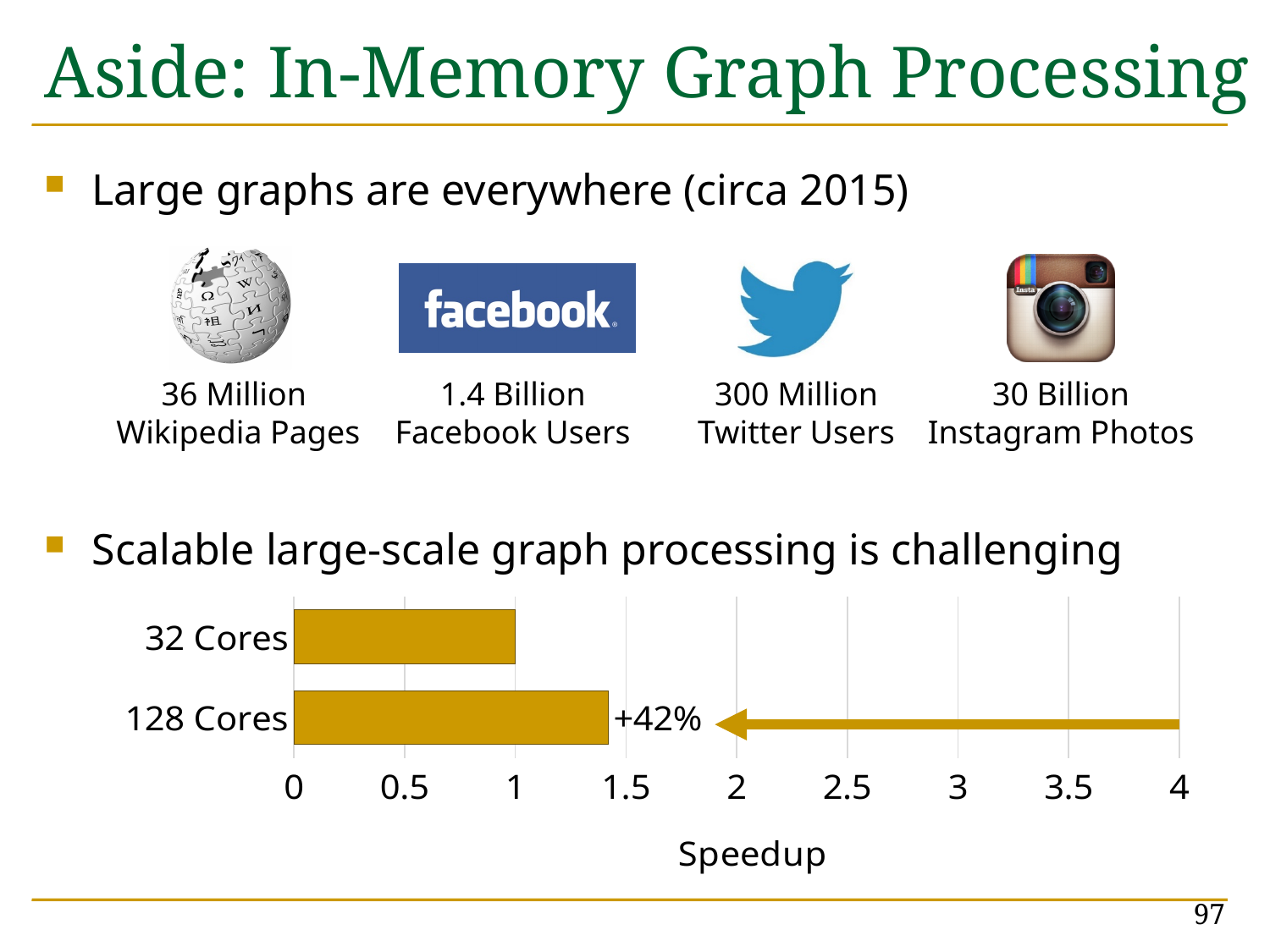
What is the label of the horizontal axis of the bar chart? Speedup Which category has the lowest speedup? 32 Cores Is the speedup for 128 Cores greater or less than 2? less What is the maximum value shown on the Speedup axis? 4 What is the speedup value for 32 Cores? 1 How many categories are plotted in the Speedup bar chart? 2 Which category has the highest speedup? 128 Cores What kind of chart is shown at the bottom of the slide? bar chart Which has a larger speedup, 32 Cores or 128 Cores? 128 Cores Is the speedup for 128 Cores greater or less than 1? greater What annotation is printed next to the 128 Cores bar? +42%